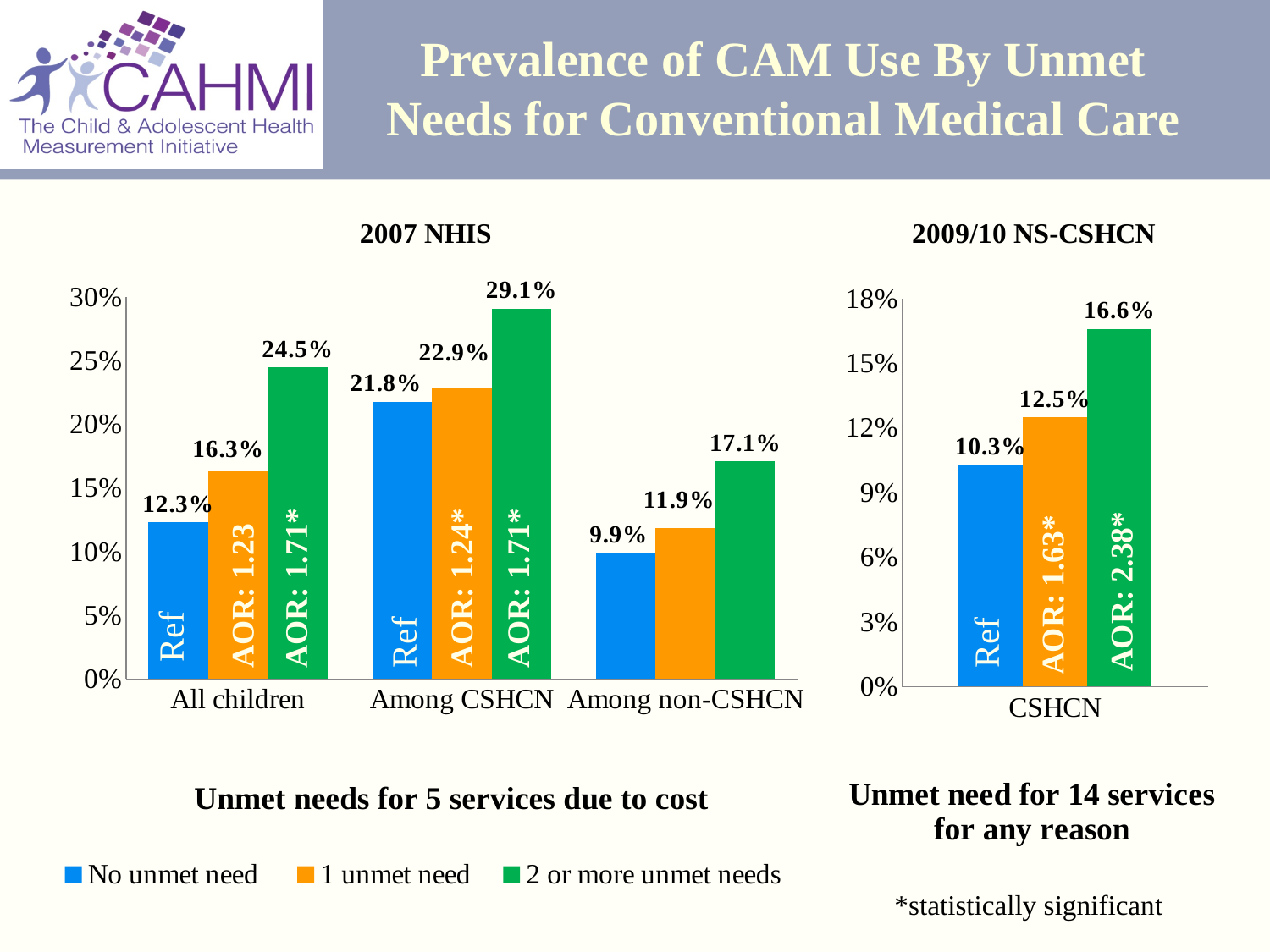
In the 2009/10 NS-CSHCN chart, what is the difference between 2 or more unmet needs and No unmet need? 6.3% In the 2007 NHIS chart, which category has the highest value for 2 or more unmet needs? Among CSHCN How many series does the legend list? 3 In the 2007 NHIS chart, what is the value for 2 or more unmet needs among CSHCN? 29.1% How many categories are shown on the x axis of the 2007 NHIS chart? 3 In the 2007 NHIS chart, what is the difference between 2 or more unmet needs and No unmet need for All children? 12.2% In the 2007 NHIS chart, which is larger: 1 unmet need for All children or 1 unmet need among non-CSHCN? All children In the 2007 NHIS chart, which category has the lowest value for No unmet need? Among non-CSHCN In the 2009/10 NS-CSHCN chart, what is the value for 1 unmet need? 12.5% In the 2009/10 NS-CSHCN chart, what AOR is printed on the 2 or more unmet needs bar? AOR: 2.38* In the 2007 NHIS chart, what is the value for No unmet need among non-CSHCN? 9.9% What kind of chart is the 2009/10 NS-CSHCN chart? Bar chart